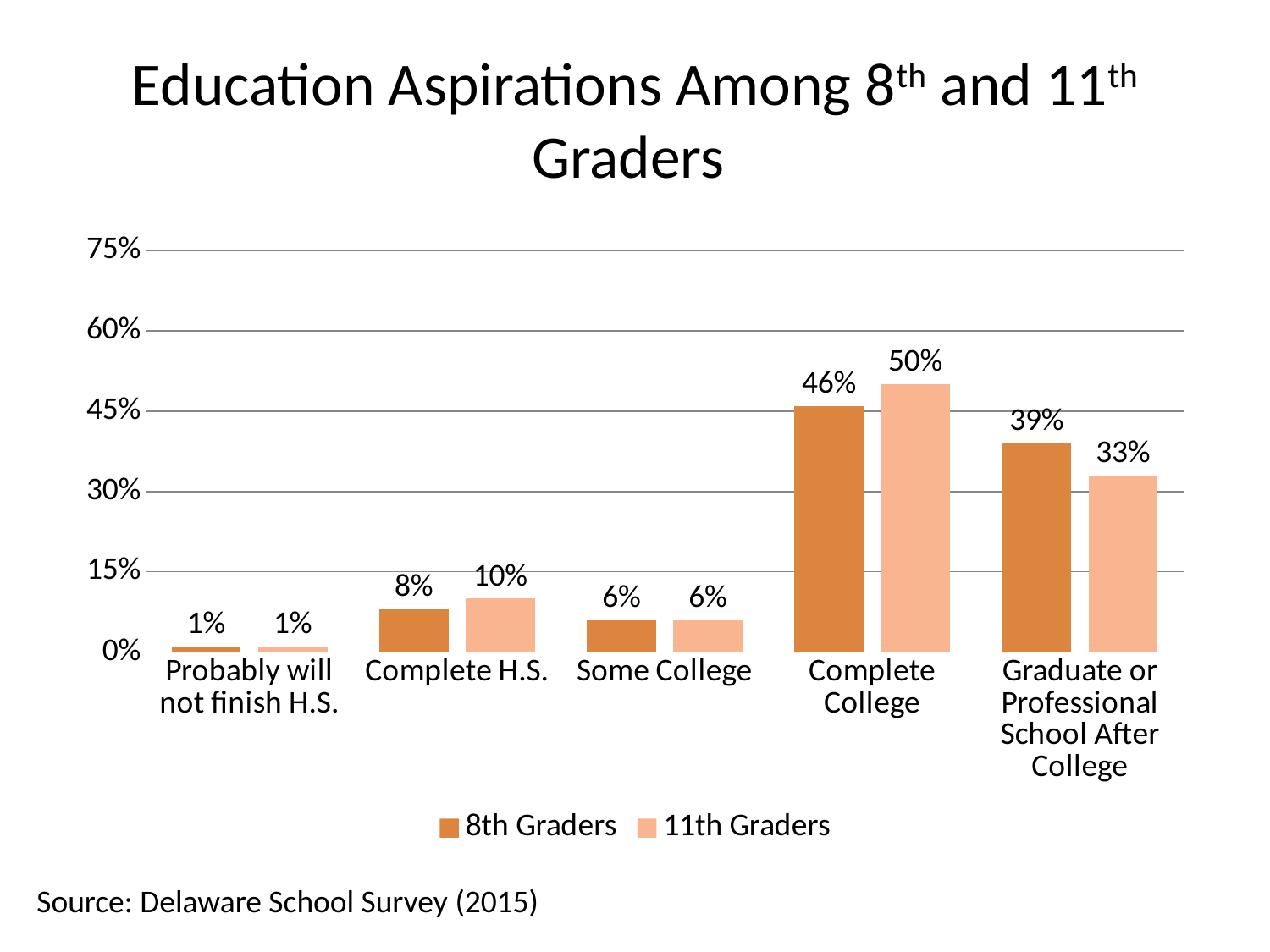
How many categories are shown on the x axis? 5 How many series does the legend list? 2 What is the source cited for the chart? Delaware School Survey (2015) What kind of chart is shown on the slide? Bar chart Is the value for 8th Graders in Graduate or Professional School After College greater or less than 30%? greater What is the value for 11th Graders in the Complete H.S. category? 10% What percentage of 11th Graders aspire to Graduate or Professional School After College? 33% Which group has the larger value for Complete College, 8th Graders or 11th Graders? 11th Graders Which category has the highest value for 11th Graders? Complete College What percentage of 8th Graders aspire to Complete College? 46% Which category has the lowest value for 8th Graders? Probably will not finish H.S. What is the difference between 8th Graders and 11th Graders for Graduate or Professional School After College? 6%